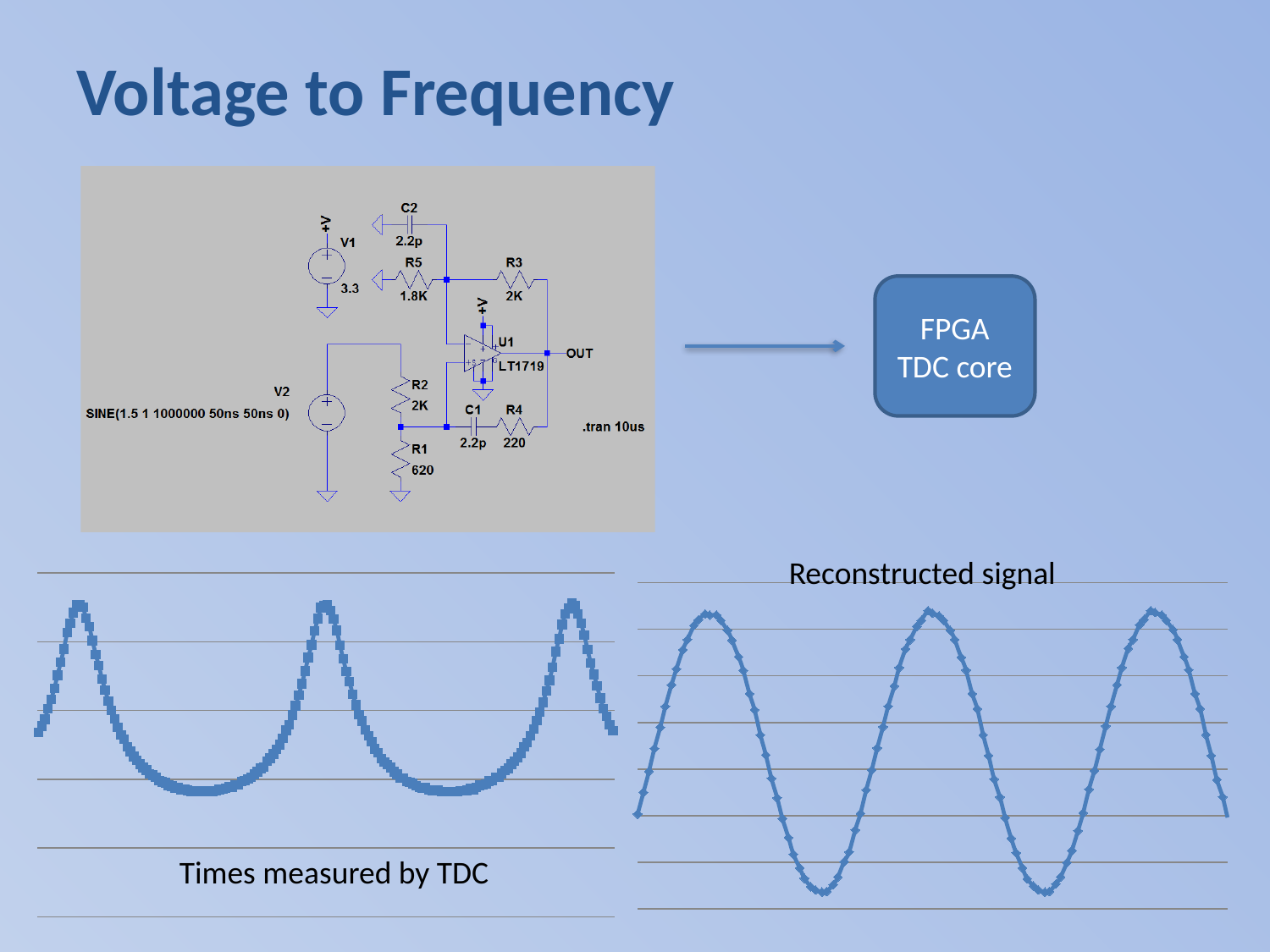
In the 'Times measured by TDC' chart, does the line rise or fall at the very start of the x axis? rise What is the caption of the chart at the bottom left of the slide? Times measured by TDC How many data series are plotted in the 'Times measured by TDC' chart? 1 How many troughs (minima) does the line in the 'Reconstructed signal' chart show? 2 How many data series are plotted in the 'Reconstructed signal' chart? 1 How many peaks does the line in the 'Reconstructed signal' chart show? 3 What kind of chart is the 'Times measured by TDC' chart at the bottom left of the slide? line chart What kind of chart is the 'Reconstructed signal' chart at the bottom right of the slide? line chart What is the title of the chart at the bottom right of the slide? Reconstructed signal In the 'Reconstructed signal' chart, does the line rise or fall immediately after its first peak? fall How many peaks does the line in the 'Times measured by TDC' chart show? 3